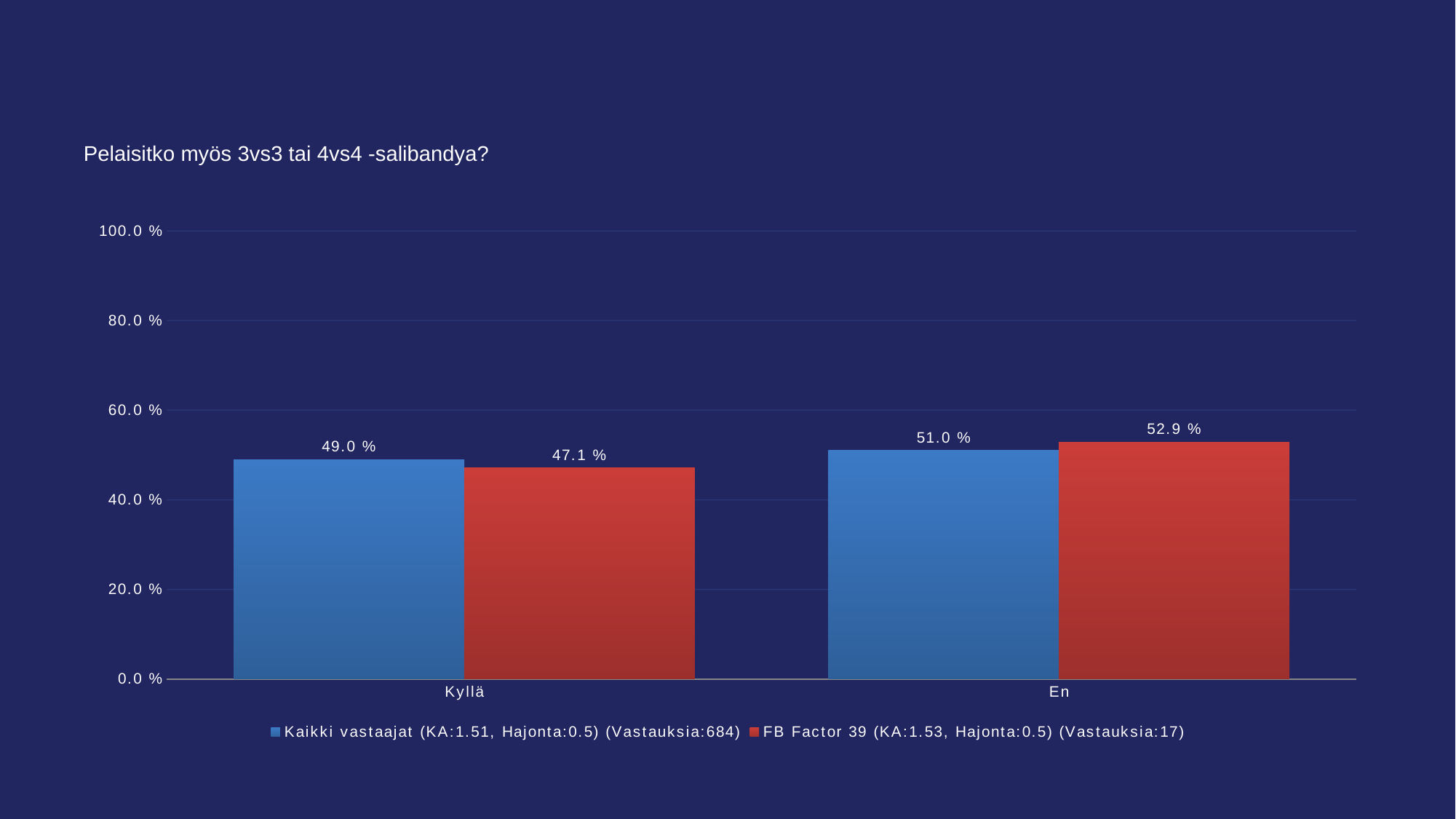
Which category has the lowest value for the Kaikki vastaajat series? Kyllä What is the difference between the Kaikki vastaajat and FB Factor 39 values in the Kyllä category? 1.9 % How many series does the legend list? 2 What is the value for FB Factor 39 in the En category? 52.9 % What is the value for Kaikki vastaajat in the Kyllä category? 49.0 % What is the value for Kaikki vastaajat in the En category? 51.0 % What is the value for FB Factor 39 in the Kyllä category? 47.1 % What kind of chart is shown on the slide? Bar chart How many categories are shown on the x axis? 2 What is the difference between the FB Factor 39 values for En and Kyllä? 5.8 % Which category has the highest value for the FB Factor 39 series? En In the En category, which series has the larger value, Kaikki vastaajat or FB Factor 39? FB Factor 39